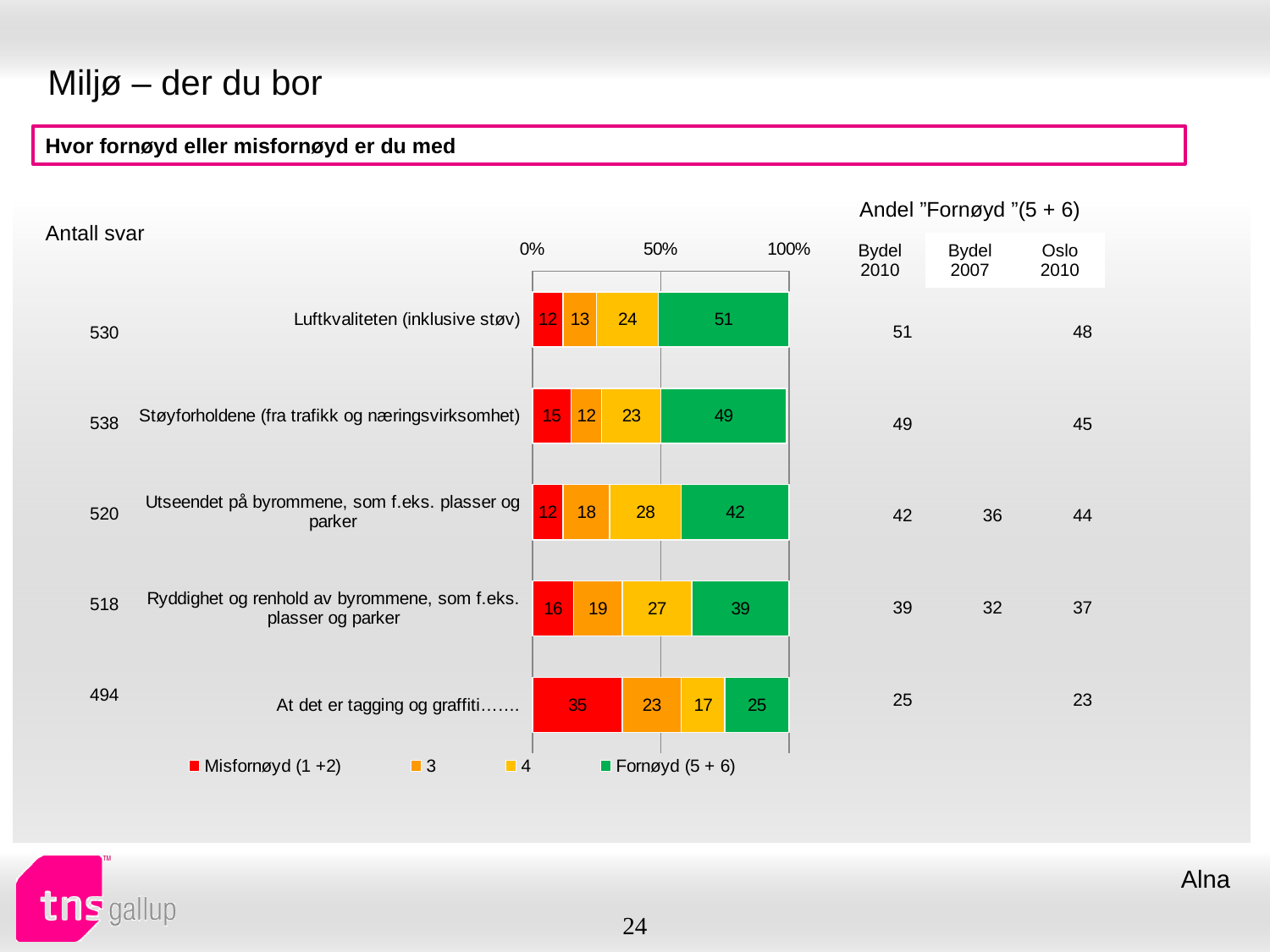
What is the value of "Misfornøyd (1 +2)" for "At det er tagging og graffiti……."? 35 What is the value of series "4" for "Utseendet på byrommene, som f.eks. plasser og parker"? 28 Which category has the lowest "Fornøyd (5 + 6)" value? At det er tagging og graffiti……. What is the value of "Fornøyd (5 + 6)" for "Luftkvaliteten (inklusive støv)"? 51 What is the difference between the "Fornøyd (5 + 6)" values for "Luftkvaliteten (inklusive støv)" and "At det er tagging og graffiti……."? 26 How many series does the legend list? 4 How many categories are shown in the chart? 5 What kind of chart is shown on the slide? Stacked bar chart Which has a larger "Misfornøyd (1 +2)" value: "Støyforholdene (fra trafikk og næringsvirksomhet)" or "Ryddighet og renhold av byrommene, som f.eks. plasser og parker"? Ryddighet og renhold av byrommene, som f.eks. plasser og parker What is the total of the stacked bar for "Luftkvaliteten (inklusive støv)"? 100 What is the value of series "3" for "Ryddighet og renhold av byrommene, som f.eks. plasser og parker"? 19 Which category has the highest "Fornøyd (5 + 6)" value? Luftkvaliteten (inklusive støv)